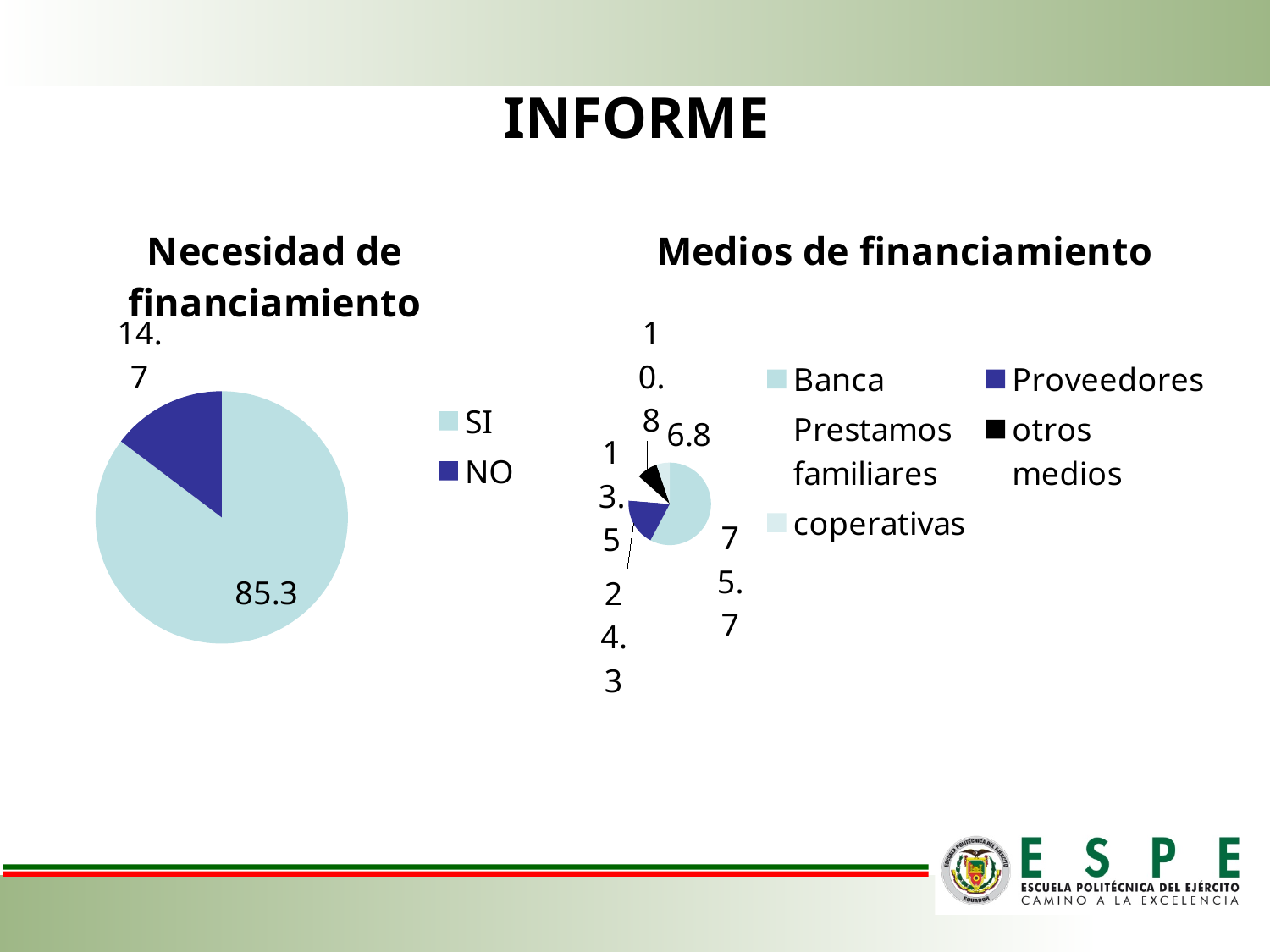
In the 'Medios de financiamiento' chart, which colour represents 'otros medios' in the legend? Black In the 'Necesidad de financiamiento' chart, what is the value for NO? 14.7 How many entries does the legend of the 'Medios de financiamiento' chart list? 5 In the 'Necesidad de financiamiento' chart, what is the difference between the SI and NO values? 70.6 In the 'Necesidad de financiamiento' chart, which category has the largest slice? SI In the 'Necesidad de financiamiento' chart, which is larger, SI or NO? SI What kind of chart is the 'Necesidad de financiamiento' chart? Pie chart In the 'Necesidad de financiamiento' chart, which category has the smallest slice? NO How many categories does the 'Necesidad de financiamiento' chart show? 2 In the 'Necesidad de financiamiento' chart, what is the value for SI? 85.3 What kind of chart is the 'Medios de financiamiento' chart? Pie chart In the 'Medios de financiamiento' chart, which category has the largest slice? Banca